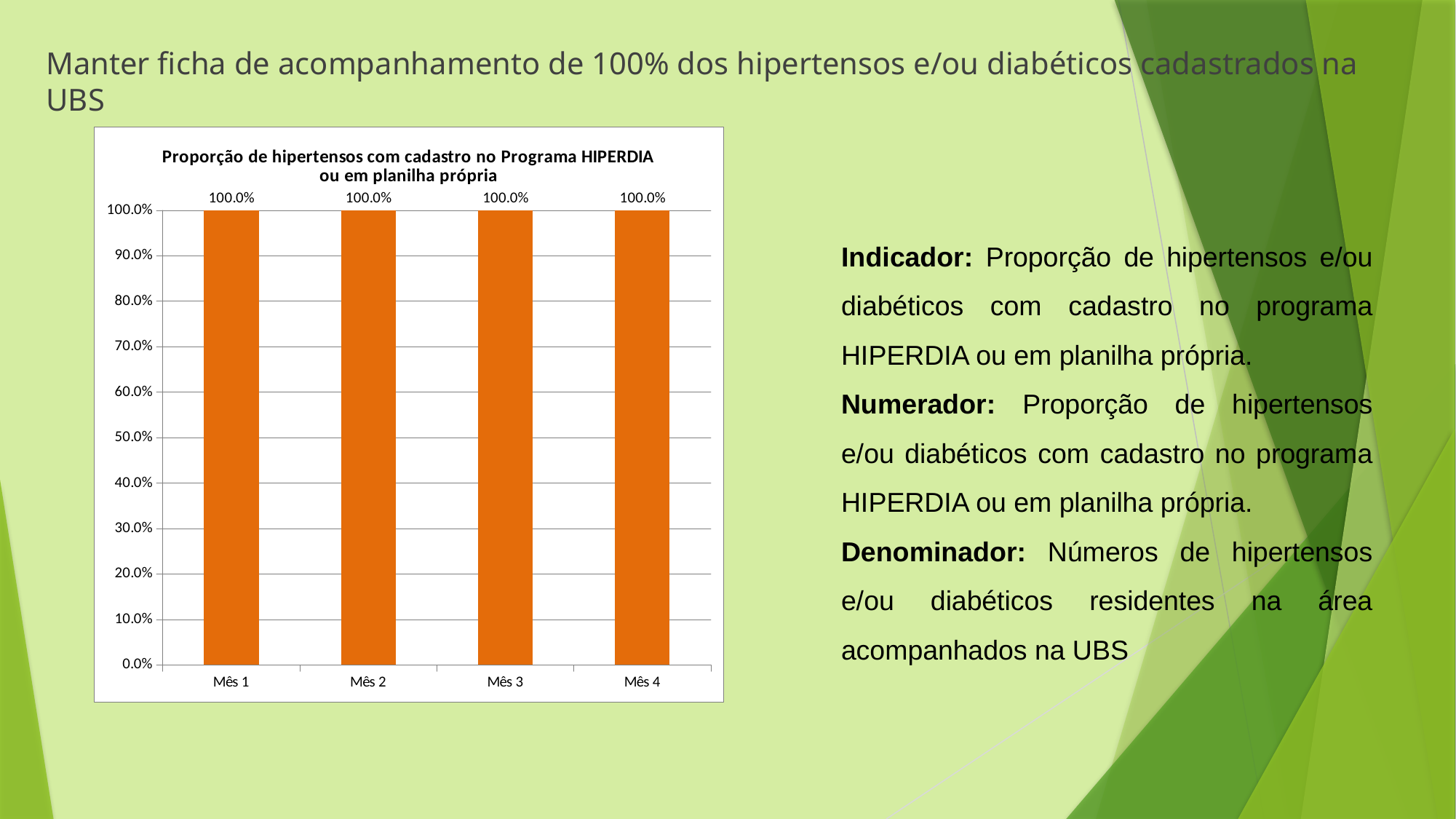
What is the difference between the values for Mês 2 and Mês 4? 0.0% What colour are the bars in the chart? orange What is the value for Mês 3? 100.0% How many categories are shown on the x axis? 4 What kind of chart is shown on the slide? bar chart What is the title of the chart? Proporção de hipertensos com cadastro no Programa HIPERDIA ou em planilha própria Do the values rise, fall or stay the same from Mês 1 to Mês 4? stay the same What is the highest value shown on the y axis? 100.0% Is the value for Mês 2 greater or less than 50.0%? greater What is the value for Mês 4? 100.0% What is the value for Mês 1? 100.0%